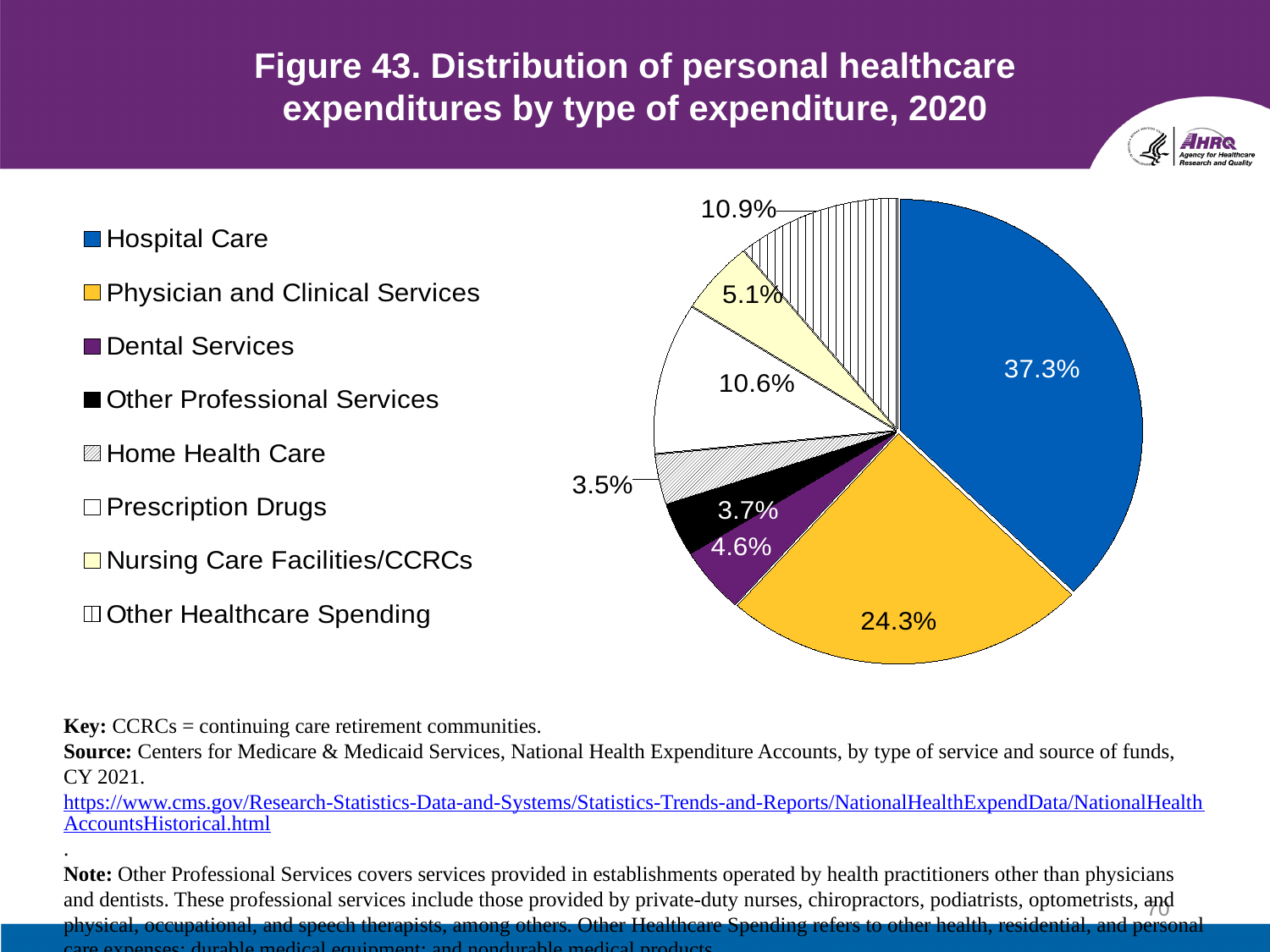
What percentage of expenditures is shown for Physician and Clinical Services? 24.3% Which type of expenditure has the largest share of the pie? Hospital Care What kind of chart is shown on the slide? Pie chart What percentage is shown for Home Health Care? 3.5% How many types of expenditure are listed in the legend? 8 Which is larger, the share for Dental Services or the share for Other Professional Services? Dental Services What percentage is shown for Prescription Drugs? 10.6% How many percentage points larger is the Hospital Care share than the Physician and Clinical Services share? 13.0 percentage points Which type of expenditure has the smallest share of the pie? Home Health Care What percentage is shown for Nursing Care Facilities/CCRCs? 5.1% What is the title of the chart? Figure 43. Distribution of personal healthcare expenditures by type of expenditure, 2020 What share of personal healthcare expenditures in 2020 went to Hospital Care? 37.3%